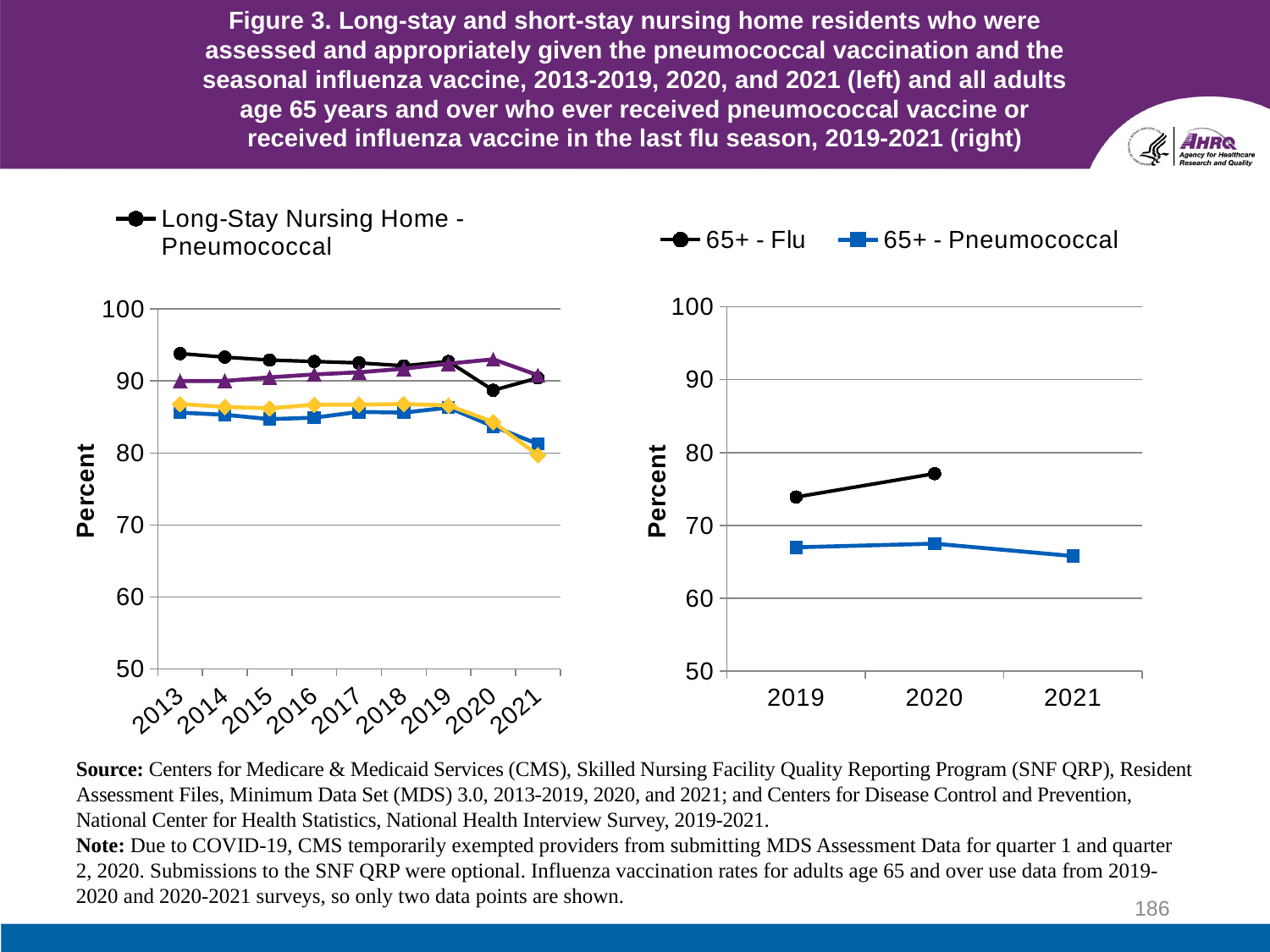
In the right chart, is the value for 65+ - Flu in 2020 greater or less than 80? less In the left chart, is the value for Long-Stay Nursing Home - Pneumococcal in 2013 greater or less than 90? greater In the right chart, does the 65+ - Flu series rise or fall from 2019 to 2020? rise How many years are shown on the x axis of the left chart? 9 How many years are shown on the x axis of the right chart? 3 In the left chart, is the value for Long-Stay Nursing Home - Pneumococcal in 2020 greater or less than 90? less In the right chart, which series has the larger value in 2020: 65+ - Flu or 65+ - Pneumococcal? 65+ - Flu What kind of chart is the left chart (Long-Stay Nursing Home - Pneumococcal)? line chart In the left chart, which is larger for Long-Stay Nursing Home - Pneumococcal: the 2013 value or the 2020 value? 2013 How many series does the legend of the right chart list? 2